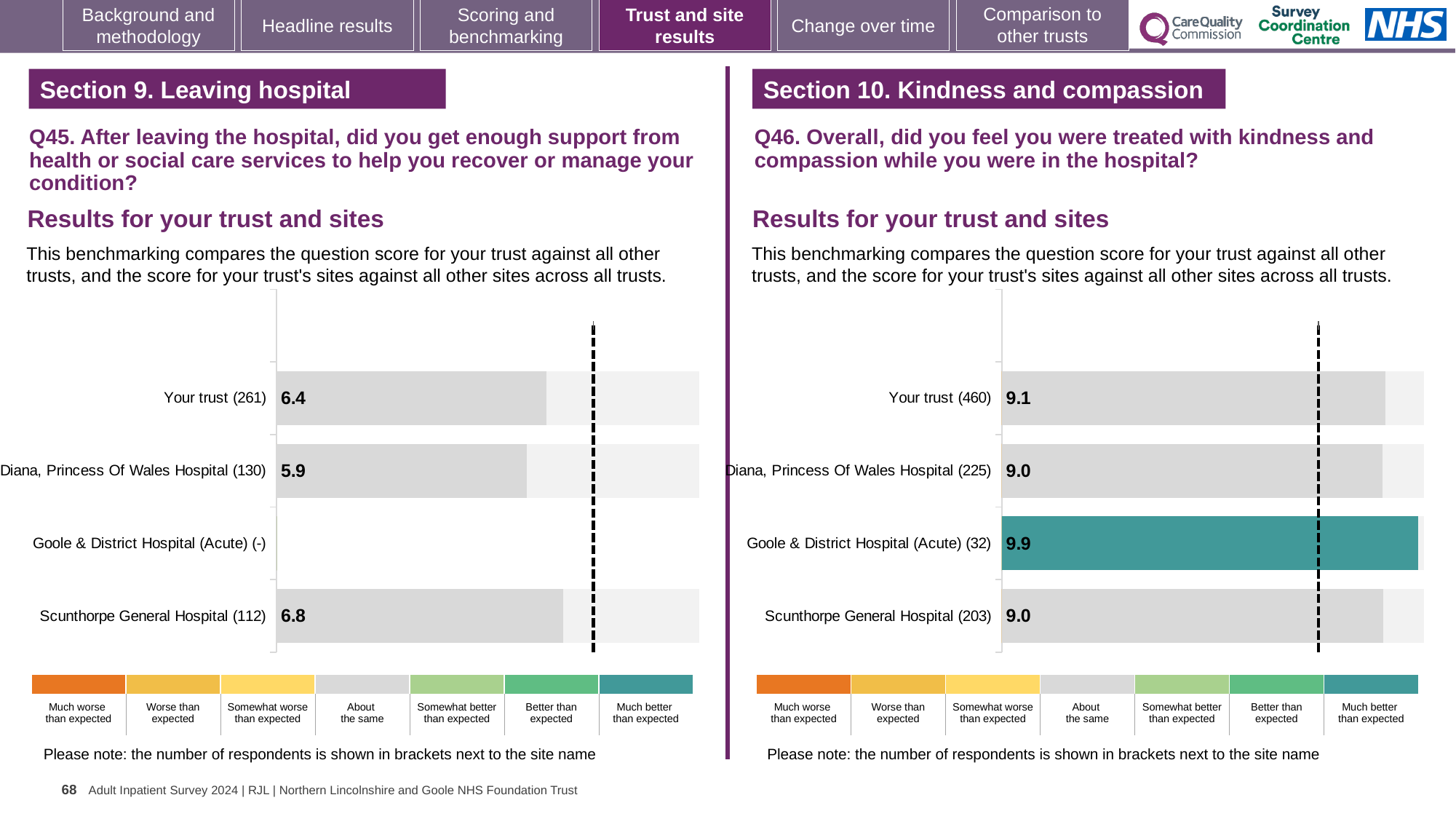
What kind of chart is used on the Q45 chart (left)? bar chart On the Q45 chart (left), what is the difference between the scores for Scunthorpe General Hospital and Diana, Princess Of Wales Hospital? 0.9 On the Q45 chart (left), what is the score for Your trust? 6.4 On the Q46 chart (right), which benchmark category does the colour of the Goole & District Hospital (Acute) bar correspond to? Much better than expected On the Q46 chart (right), is the score for Your trust larger or smaller than the score for Diana, Princess Of Wales Hospital? larger On the Q45 chart (left), what is the score for Scunthorpe General Hospital? 6.8 On the Q46 chart (right), how many respondents are shown in brackets for Scunthorpe General Hospital? 203 On the Q45 chart (left), which site has the lowest score shown? Diana, Princess Of Wales Hospital On the Q46 chart (right), which site has the highest score? Goole & District Hospital (Acute) On the Q45 chart (left), how many respondents are shown in brackets for Your trust? 261 On the Q46 chart (right), what is the score for Goole & District Hospital (Acute)? 9.9 On the Q46 chart (right), what is the difference between the scores for Goole & District Hospital (Acute) and Your trust? 0.8